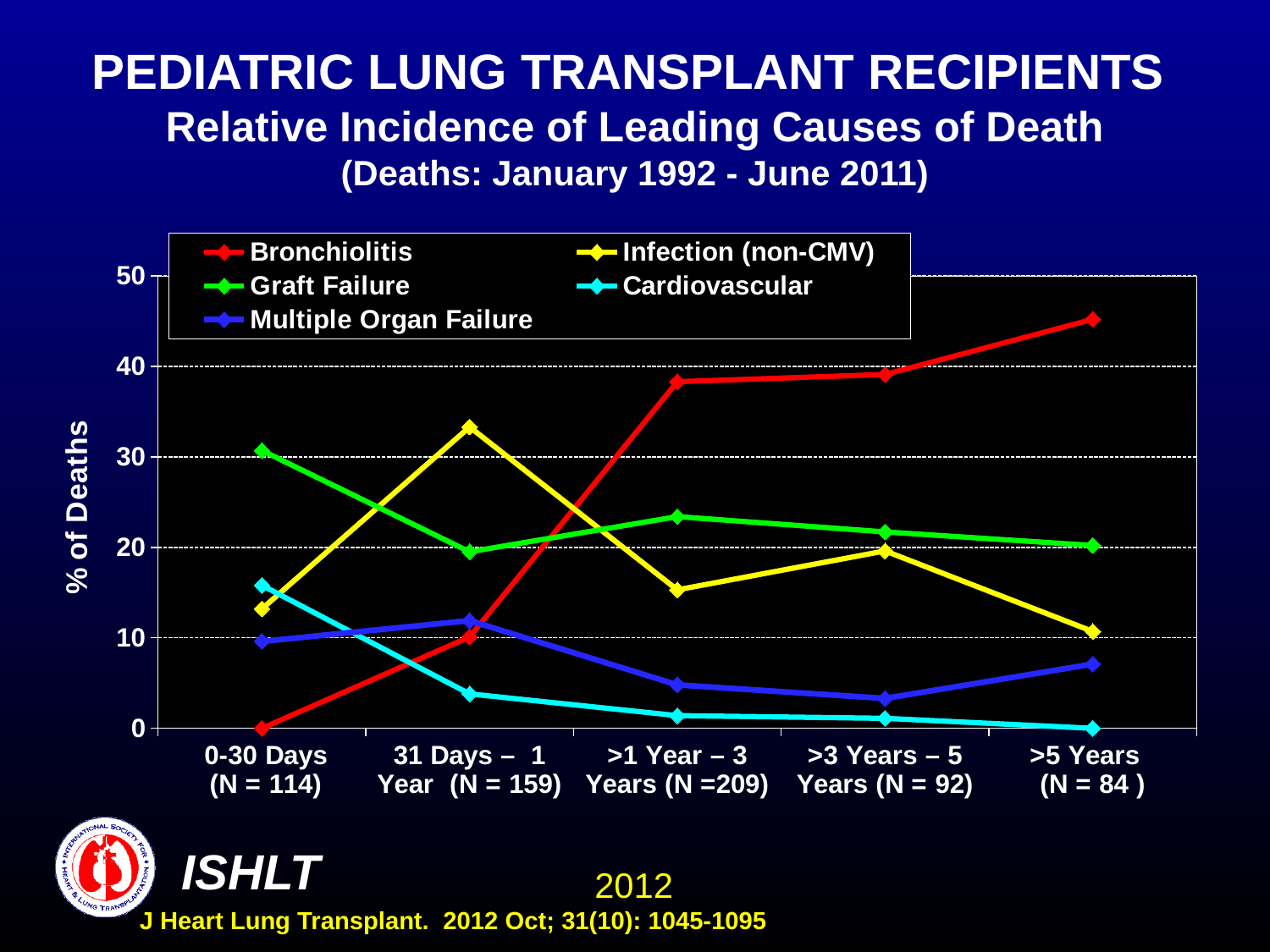
Is the value for Cardiovascular in the >1 Year – 3 Years period greater or less than 10? less Is the value for Bronchiolitis in the >5 Years period greater or less than 40? greater Is the value for Infection (non-CMV) in the 31 Days – 1 Year period greater or less than 30? greater Which cause of death has the highest % of deaths in the 0-30 Days period? Graft Failure How many time-period categories are shown on the x axis? 5 In the >3 Years – 5 Years period, which is larger: Graft Failure or Multiple Organ Failure? Graft Failure Which cause of death has the highest % of deaths in the 31 Days – 1 Year period? Infection (non-CMV) What kind of chart is shown on the slide? line chart Does the Bronchiolitis line rise or fall from 0-30 Days to >5 Years? rise How many series does the legend list? 5 Which cause of death has the lowest % of deaths in the 0-30 Days period? Bronchiolitis Which cause of death has the highest % of deaths in the >5 Years period? Bronchiolitis